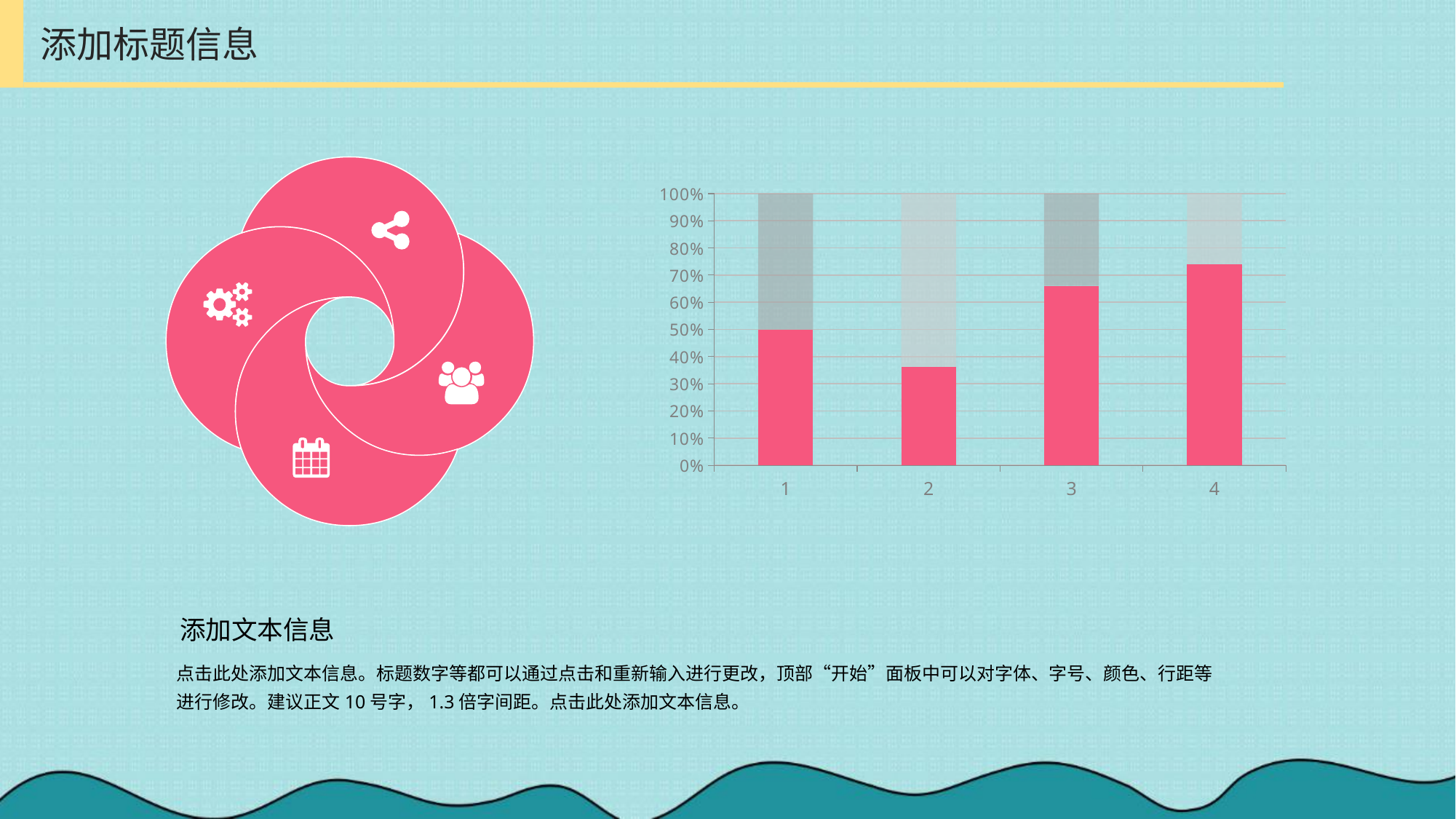
Do the pink segments rise or fall from category 2 to category 4? rise Is the pink segment for category 3 greater or less than 60%? greater Which has a larger pink segment, category 2 or category 4? category 4 What is the value of the pink segment for category 1? 50% What is the total height of the stacked bar for category 1? 100% How many categories are shown on the x axis of the chart? 4 Is the pink segment for category 4 greater or less than 70%? greater Which category has the highest pink segment? 4 Which has a larger pink segment, category 1 or category 3? category 3 What kind of chart is shown on the slide? bar chart Is the pink segment for category 2 greater or less than 40%? less Which category has the lowest pink segment? 2